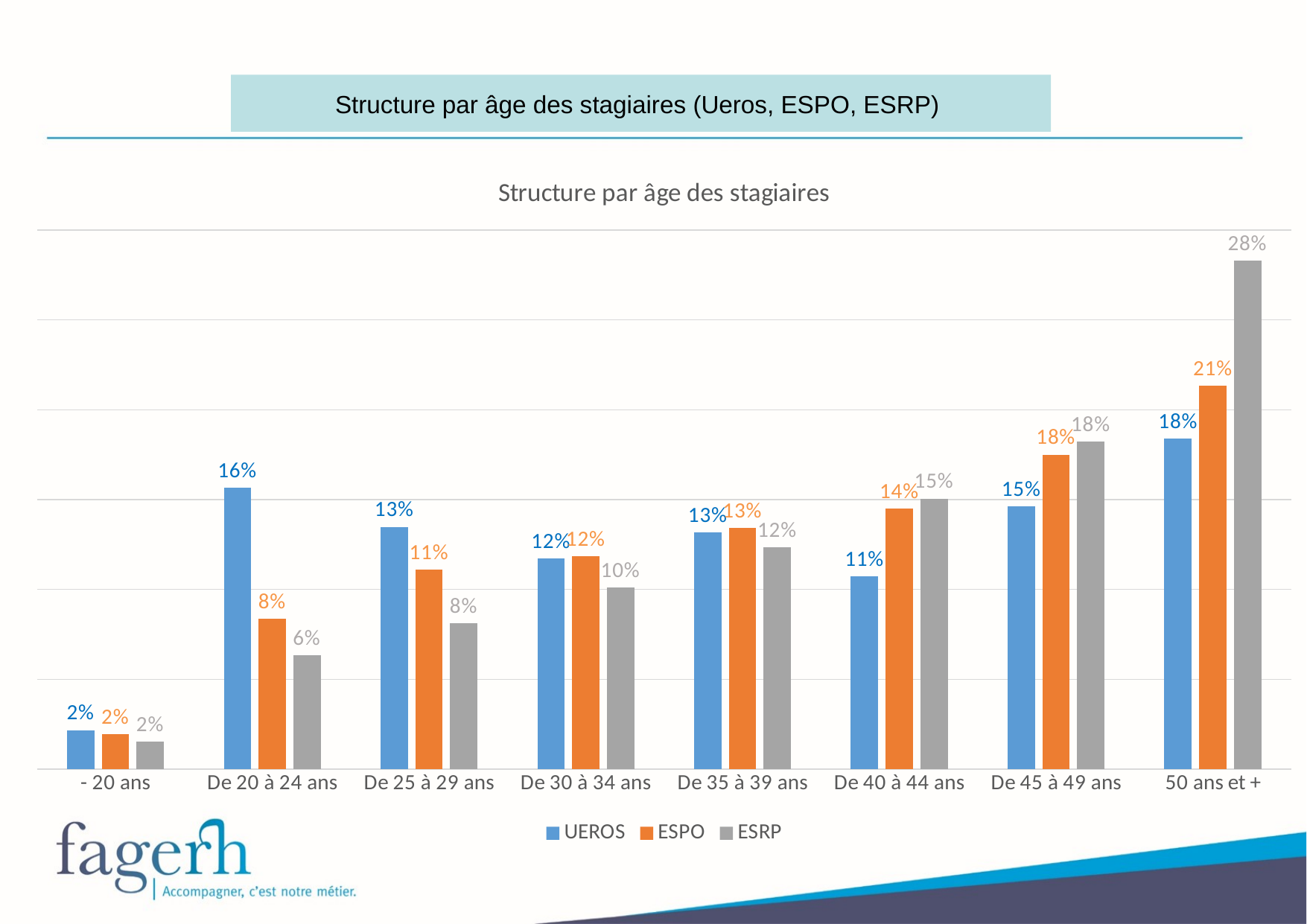
How many series does the legend list? 3 What kind of chart is shown on the slide? Bar chart How many age categories are shown on the x axis? 8 Which age category has the lowest value for UEROS? - 20 ans What is the title of the chart? Structure par âge des stagiaires Do the ESRP values rise or fall from 'De 20 à 24 ans' to '50 ans et +'? Rise Which age category has the highest value for ESRP? 50 ans et + What is the value for ESRP in the '50 ans et +' category? 28% What is the difference between the ESRP and UEROS values in the '50 ans et +' category? 10% In the 'De 20 à 24 ans' category, which series has the larger value, UEROS or ESRP? UEROS What is the value for ESPO in the 'De 40 à 44 ans' category? 14% What is the value for UEROS in the 'De 20 à 24 ans' category? 16%